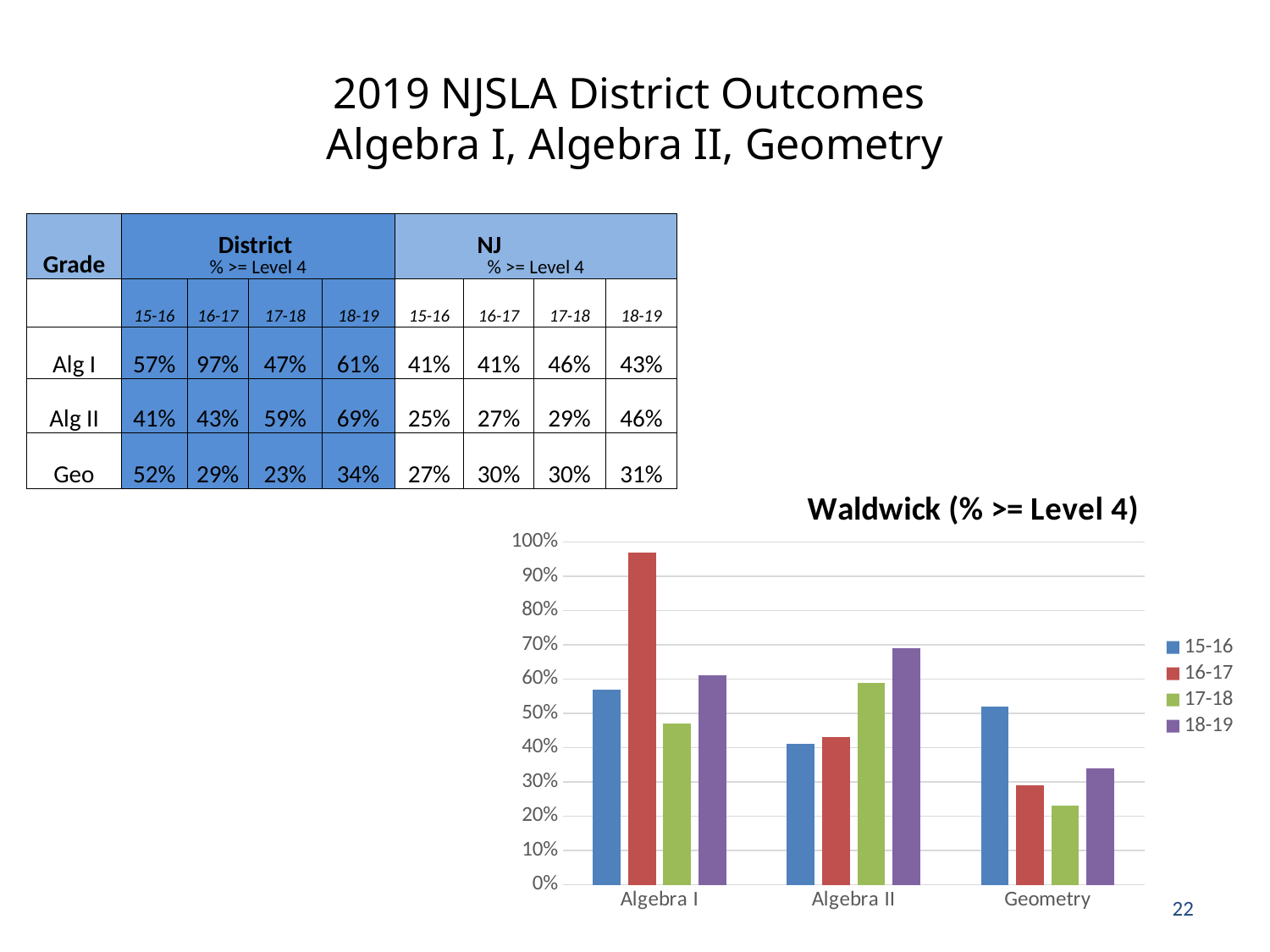
How many series does the legend of the Waldwick (% >= Level 4) chart list? 4 In the Waldwick (% >= Level 4) chart, is the 17-18 value for Geometry greater or less than 30%? less What colour are the 18-19 bars in the Waldwick (% >= Level 4) chart? purple In the Waldwick (% >= Level 4) chart, do the values for Algebra II rise or fall from 15-16 to 18-19? rise In the Waldwick (% >= Level 4) chart, which subject has the tallest bar overall? Algebra I How many subject categories are shown on the x axis of the Waldwick (% >= Level 4) chart? 3 In the Waldwick (% >= Level 4) chart, is the 18-19 value for Algebra II greater or less than 60%? greater What type of chart is the Waldwick (% >= Level 4) chart? bar chart In the Waldwick (% >= Level 4) chart, which year series has the lowest value for Geometry? 17-18 In the Waldwick (% >= Level 4) chart, is the 16-17 value for Algebra I greater or less than 90%? greater In the Waldwick (% >= Level 4) chart, which year series has the highest value for Algebra I? 16-17 In the Waldwick (% >= Level 4) chart, which is larger for Algebra II: the 15-16 value or the 18-19 value? 18-19